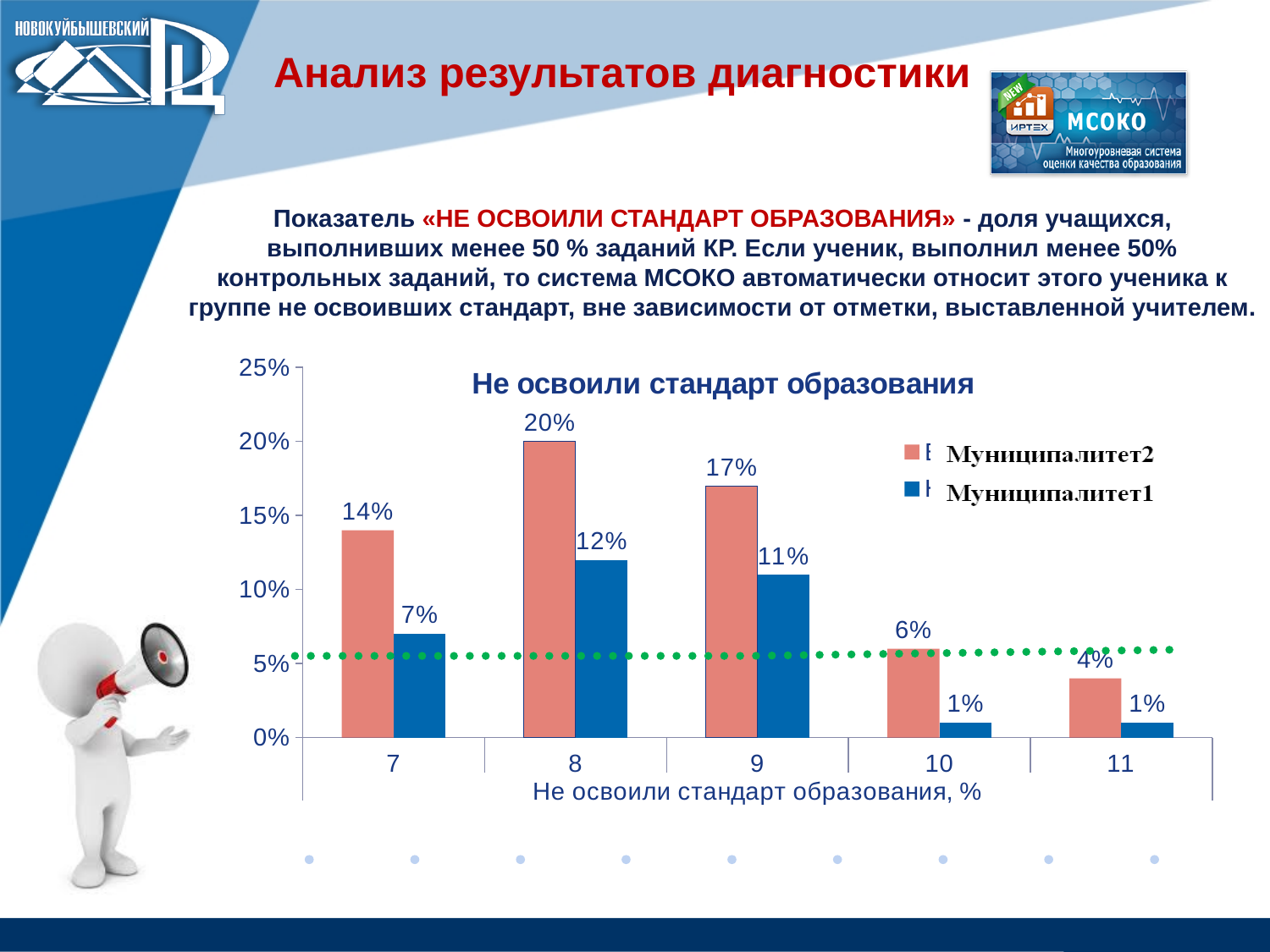
What is the title of the chart? Не освоили стандарт образования In which category is the value for Муниципалитет2 the highest? 8 What is the value for Муниципалитет1 in category 9? 11% In which category is the value for Муниципалитет1 the lowest, among categories 7, 8 and 9? 7 How many categories are shown on the x axis? 5 How many series does the legend list? 2 What is the value for Муниципалитет2 in category 11? 4% Do the values for Муниципалитет2 rise or fall from category 8 to category 11? fall What is the value for Муниципалитет2 in category 8? 20% Which is larger in category 10: Муниципалитет2 or Муниципалитет1? Муниципалитет2 What type of chart is shown on the slide? bar chart What is the difference between Муниципалитет2 and Муниципалитет1 in category 7? 7%